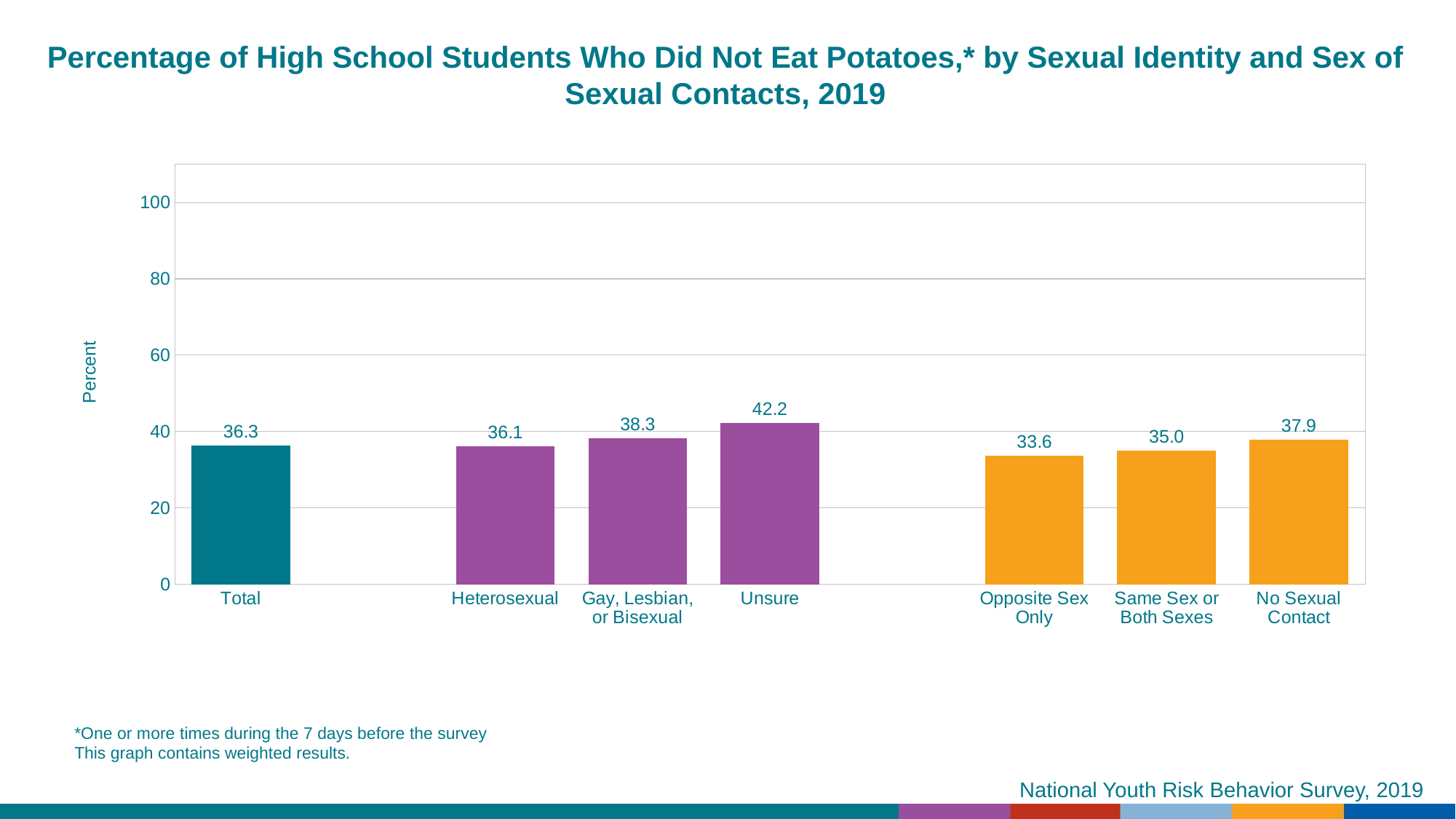
What is the value for Total? 36.3 Which category has the lowest value? Opposite Sex Only What is the value for Opposite Sex Only? 33.6 Which category has the highest value? Unsure How many bars are shown in the chart? 7 What is the value for Unsure? 42.2 What is the value for No Sexual Contact? 37.9 Which is larger, the value for Gay, Lesbian, or Bisexual or the value for Same Sex or Both Sexes? Gay, Lesbian, or Bisexual Is the value for Unsure greater or less than 40? greater What is the difference between the values for No Sexual Contact and Opposite Sex Only? 4.3 What kind of chart is shown on the slide? Bar chart What is the difference between the values for Unsure and Heterosexual? 6.1